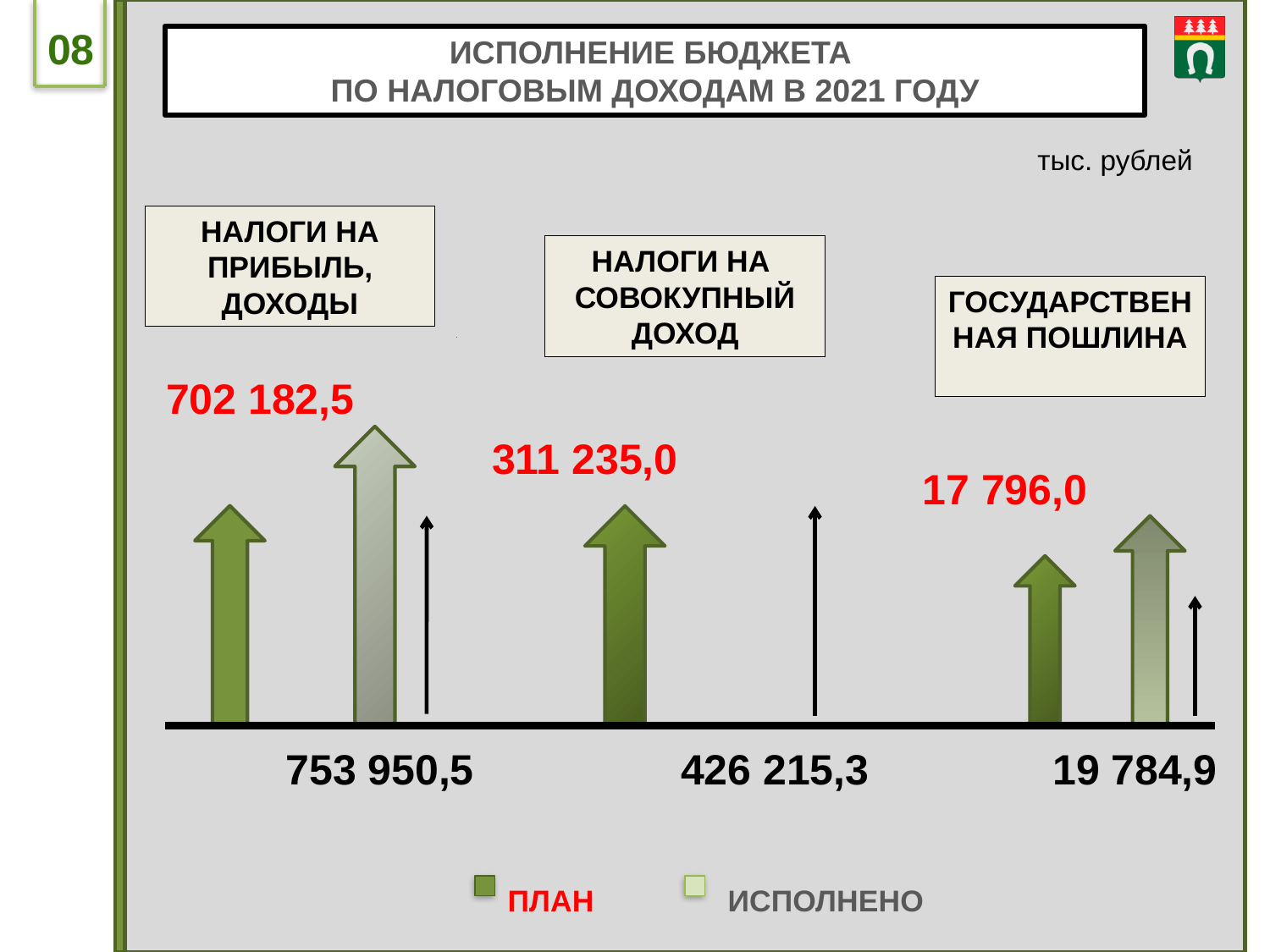
What is the executed (ИСПОЛНЕНО) value for НАЛОГИ НА ПРИБЫЛЬ, ДОХОДЫ? 753 950,5 What is the executed (ИСПОЛНЕНО) value for НАЛОГИ НА СОВОКУПНЫЙ ДОХОД? 426 215,3 What is the plan (ПЛАН) value for ГОСУДАРСТВЕННАЯ ПОШЛИНА? 17 796,0 For ГОСУДАРСТВЕННАЯ ПОШЛИНА, which is larger: the plan value or the executed value? the executed value (ИСПОЛНЕНО) Which category has the highest executed (ИСПОЛНЕНО) value? НАЛОГИ НА ПРИБЫЛЬ, ДОХОДЫ What is the plan (ПЛАН) value for НАЛОГИ НА СОВОКУПНЫЙ ДОХОД? 311 235,0 How many tax revenue categories are shown on the chart? 3 By how much does the executed value exceed the plan value for НАЛОГИ НА СОВОКУПНЫЙ ДОХОД? 114 980,3 Which category has the lowest plan (ПЛАН) value? ГОСУДАРСТВЕННАЯ ПОШЛИНА What is the executed (ИСПОЛНЕНО) value for ГОСУДАРСТВЕННАЯ ПОШЛИНА? 19 784,9 What is the plan (ПЛАН) value for НАЛОГИ НА ПРИБЫЛЬ, ДОХОДЫ? 702 182,5 How many series does the legend list? 2